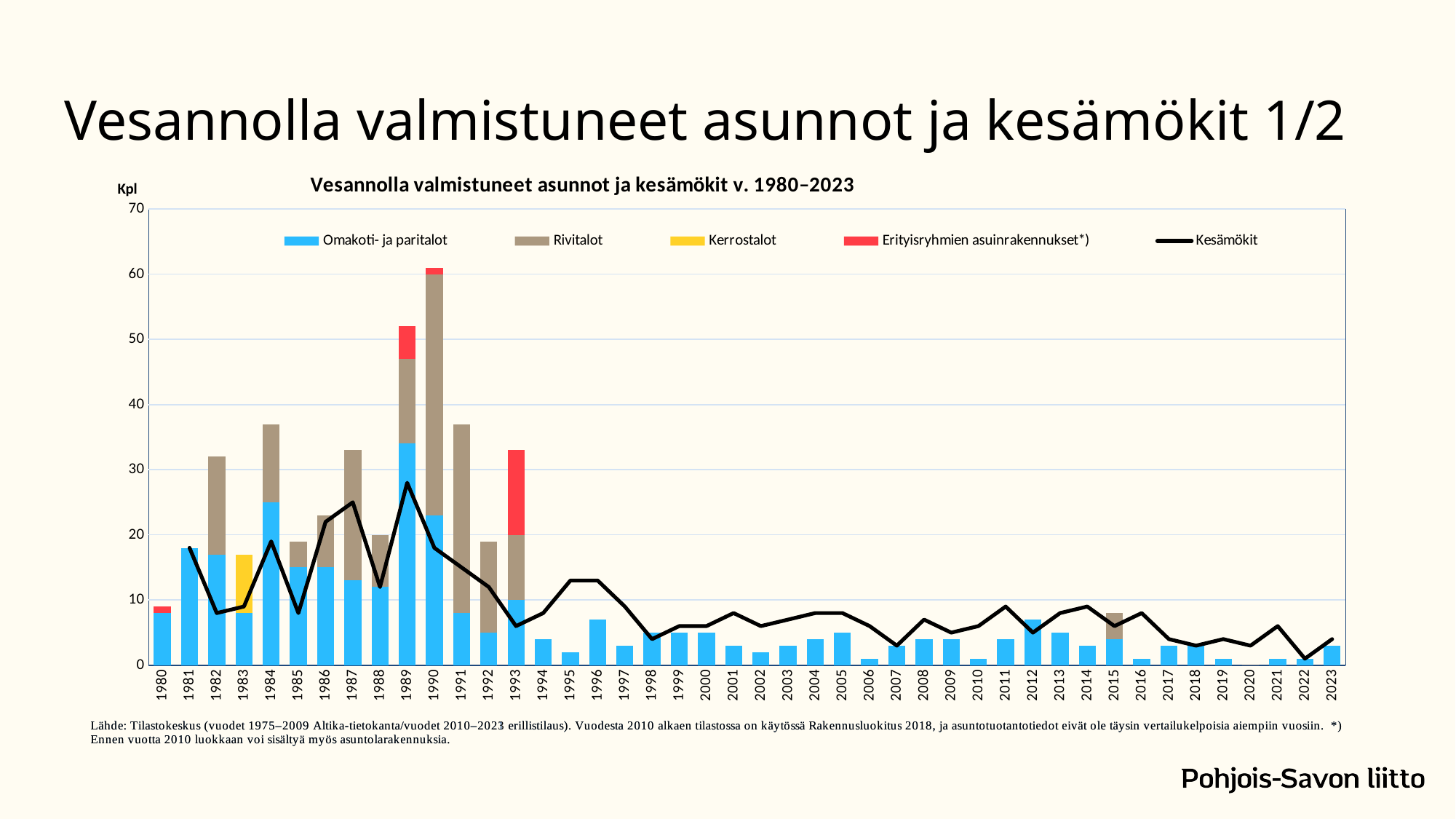
Is the Kesämökit value for 1989 greater or less than 20? greater How many years are shown on the x axis? 44 Is the total stacked bar for 1990 greater or less than 50? greater Does the Kesämökit line rise or fall from 1989 to 1993? fall In which year does the Kesämökit line reach its highest point? 1989 Is the total stacked bar for 1984 greater or less than 30? greater Which year has the higher Kesämökit value, 1995 or 1998? 1995 What kind of chart is shown on the slide? stacked bar chart with a line Which year has the tallest stacked bar? 1990 How many series does the legend list? 5 Which year has the larger total stacked bar, 1981 or 1982? 1982